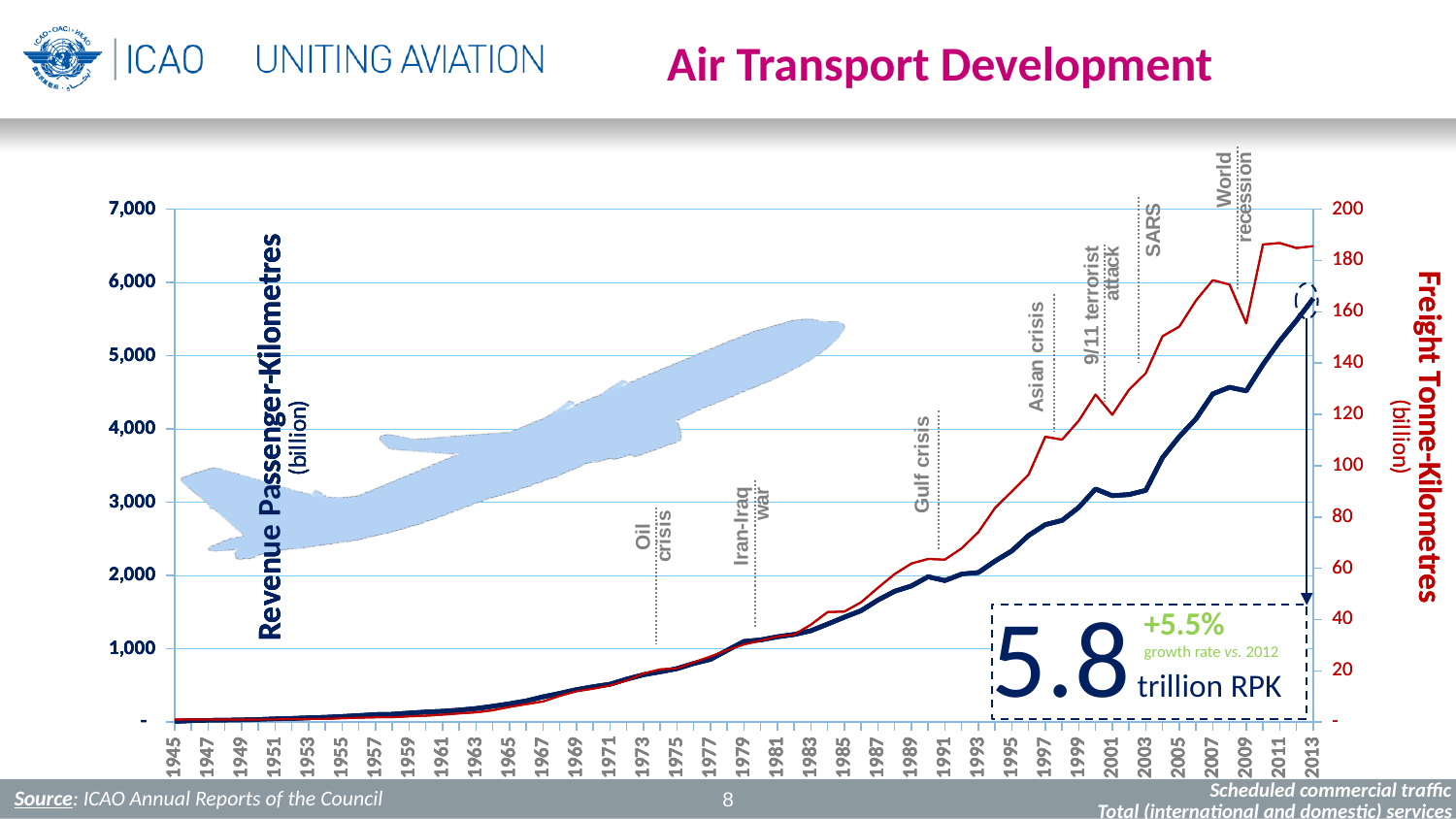
Is the Revenue Passenger-Kilometres value for 1995 greater or less than 3,000? less How many crisis or event annotations are marked along the chart? 7 What is the chart's title? Air Transport Development What growth rate vs. 2012 is shown in the callout box? +5.5% Is the Freight Tonne-Kilometres value for 2013 greater or less than 160? greater Do Revenue Passenger-Kilometres generally rise or fall from 1945 to 2013? rise In which year does the Revenue Passenger-Kilometres series reach its highest value? 2013 What value of Revenue Passenger-Kilometres is highlighted for 2013? 5.8 trillion RPK What quantity is plotted on the left vertical axis? Revenue Passenger-Kilometres (billion) What kind of chart is shown on the slide? line chart Is the Revenue Passenger-Kilometres value for 2013 greater or less than 5,000? greater